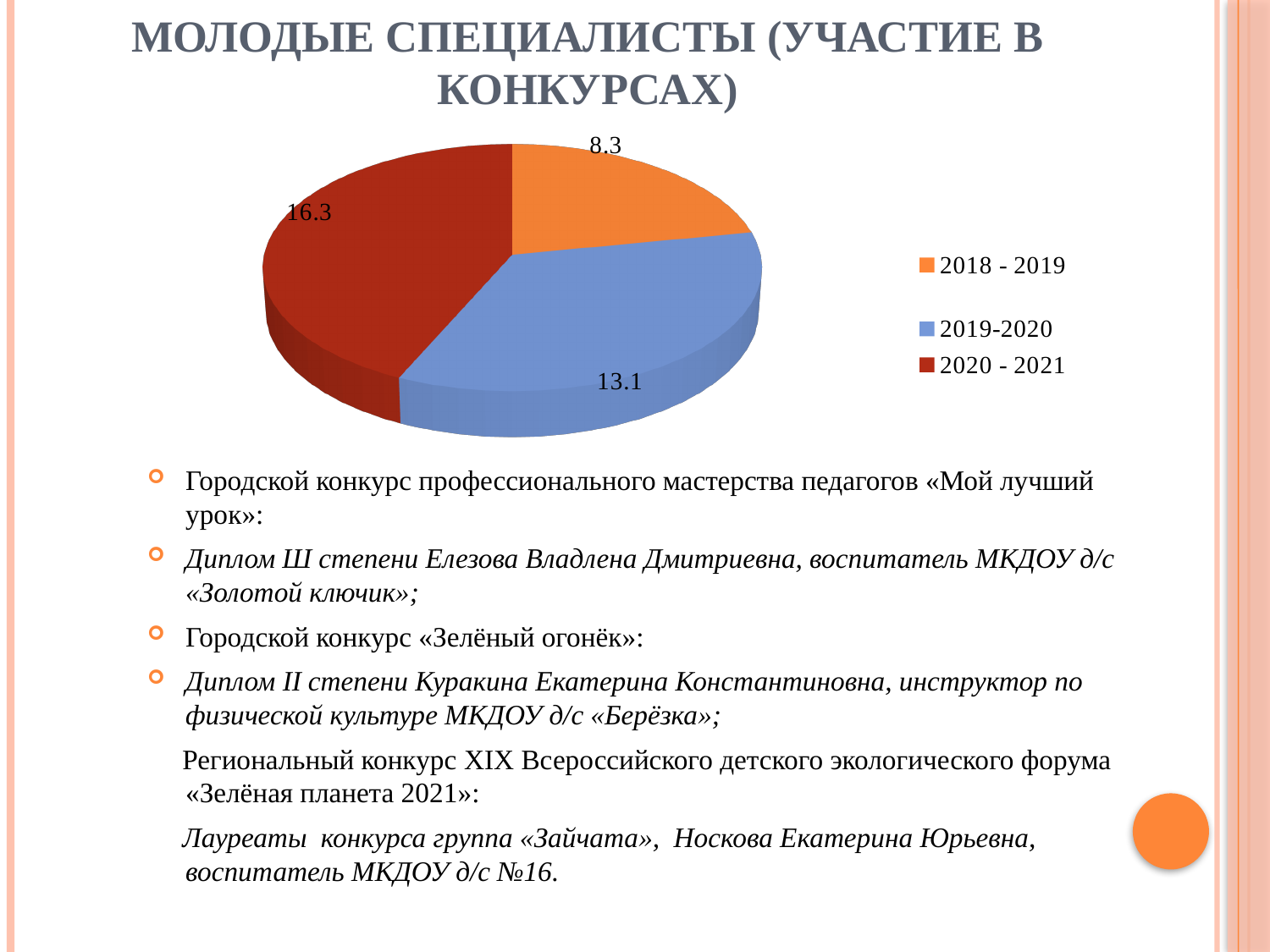
Which is larger, the value for 2019-2020 or the value for 2018 - 2019? 2019-2020 What value is shown for the 2018 - 2019 slice of the pie chart? 8.3 What kind of chart is shown on the slide? Pie chart Which period has the largest slice in the pie chart? 2020 - 2021 What value is shown for the 2020 - 2021 slice of the pie chart? 16.3 How many slices does the pie chart have? 3 How many entries does the legend list? 3 What is the difference between the values for 2020 - 2021 and 2018 - 2019? 8.0 What value is shown for the 2019-2020 slice of the pie chart? 13.1 Which period has the smallest slice in the pie chart? 2018 - 2019 What colour is the 2020 - 2021 slice in the pie chart? Red What is the difference between the values for 2020 - 2021 and 2019-2020? 3.2